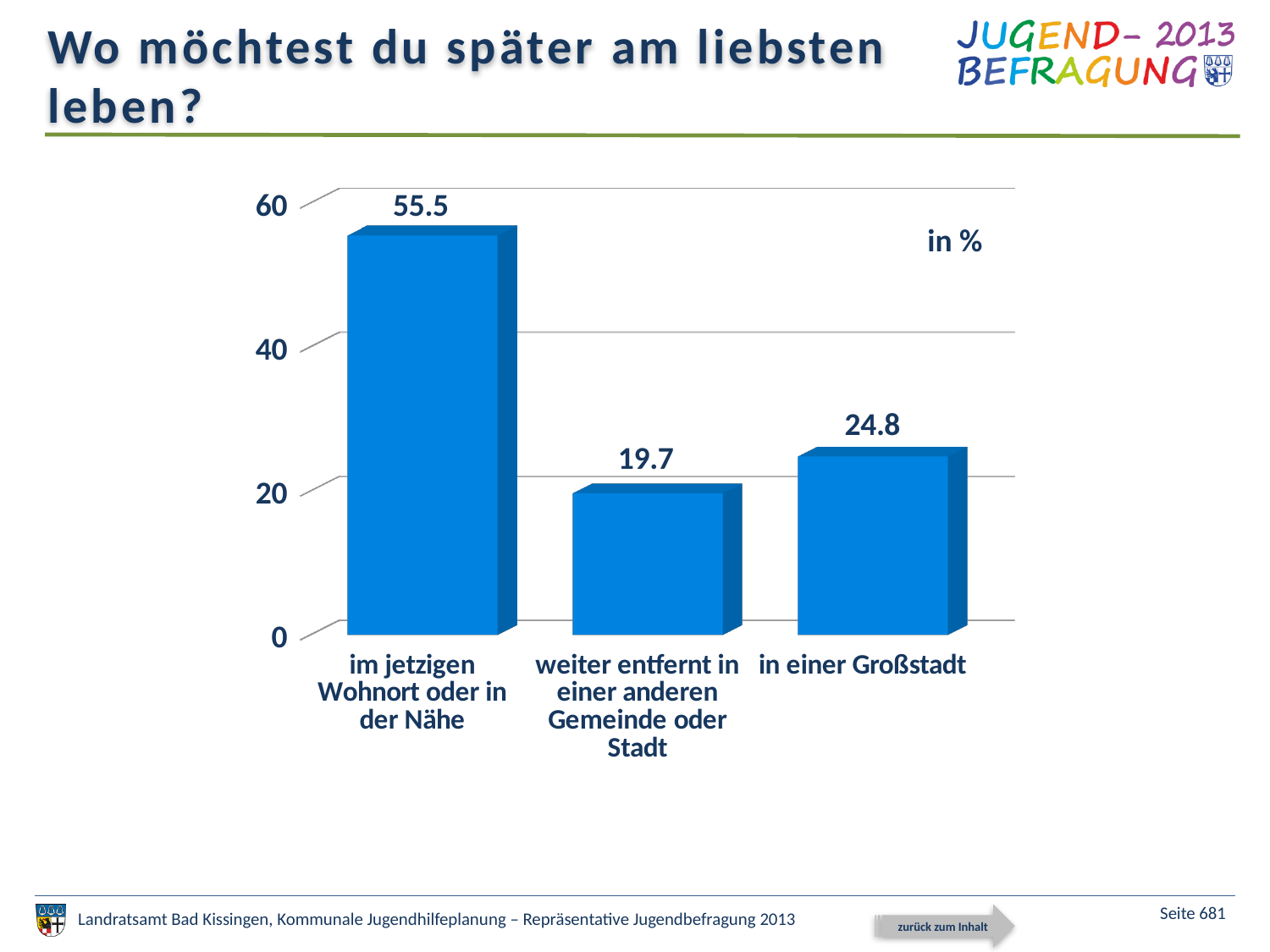
What is the value for "weiter entfernt in einer anderen Gemeinde oder Stadt"? 19.7 Which is larger: the value for "in einer Großstadt" or for "weiter entfernt in einer anderen Gemeinde oder Stadt"? in einer Großstadt Which category has the highest value? im jetzigen Wohnort oder in der Nähe What is the difference between the values for "im jetzigen Wohnort oder in der Nähe" and "in einer Großstadt"? 30.7 How many categories are shown in the chart? 3 What is the difference between the values for "in einer Großstadt" and "weiter entfernt in einer anderen Gemeinde oder Stadt"? 5.1 Is the value for "im jetzigen Wohnort oder in der Nähe" greater or less than 40? greater What is the value for "in einer Großstadt"? 24.8 What is the value for "im jetzigen Wohnort oder in der Nähe"? 55.5 In what unit are the values given, according to the label on the chart? in % Which category has the lowest value? weiter entfernt in einer anderen Gemeinde oder Stadt What kind of chart is shown on the slide? bar chart